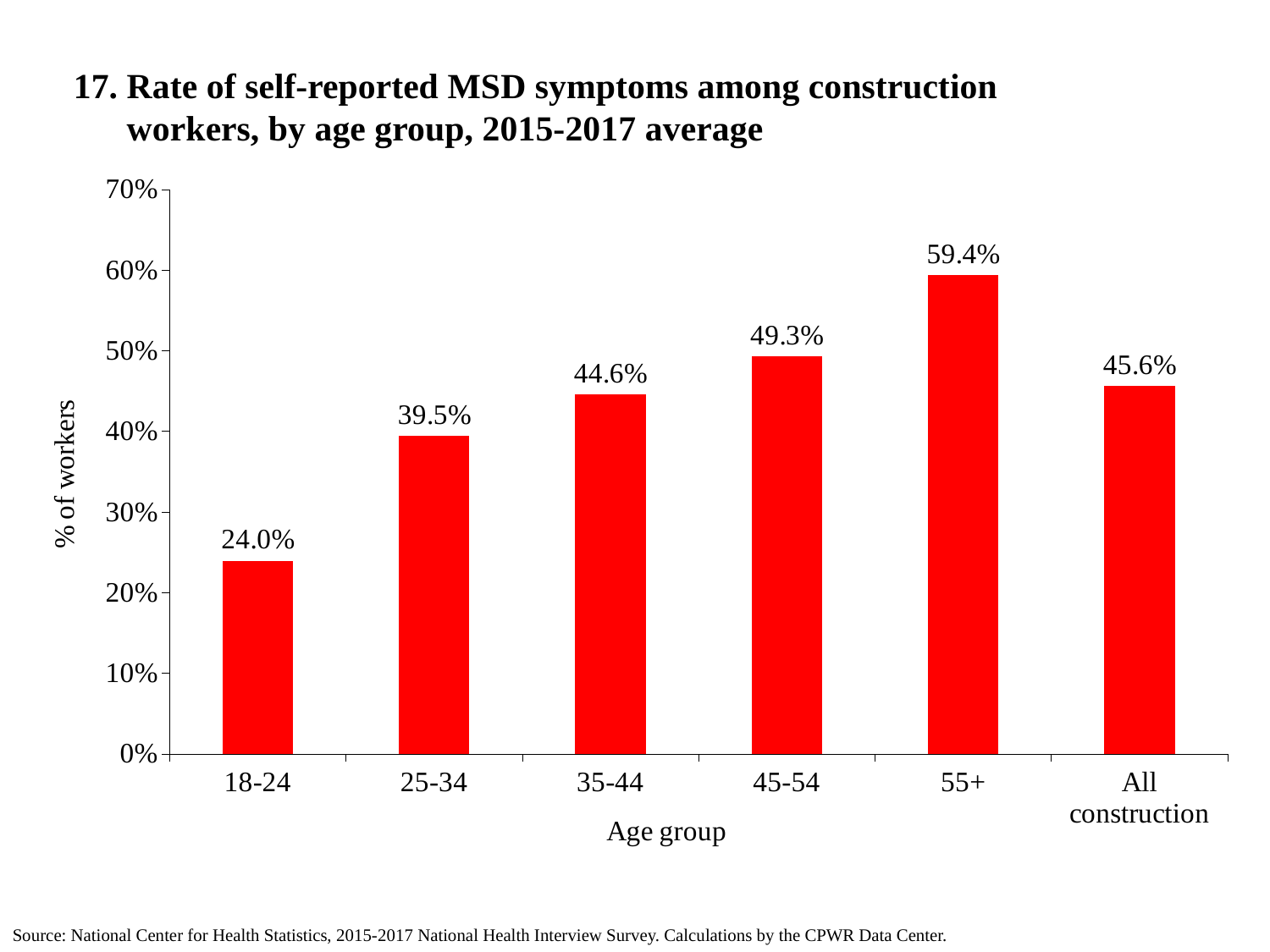
Which is larger, the value for 35-44 or the value for All construction? All construction What is the label of the y axis? % of workers What is the value shown for the 45-54 age group? 49.3% What is the rate of self-reported MSD symptoms for the 18-24 age group? 24.0% What kind of chart is shown on the slide? Bar chart How many bars are shown on the chart? 6 Do the values rise or fall across the age groups from 18-24 to 55+? Rise What is the difference between the 55+ value and the 18-24 value? 35.4 percentage points Which age group has the highest rate of self-reported MSD symptoms? 55+ Which category has the lowest value on the chart? 18-24 What is the value shown for All construction? 45.6% Is the value for 25-34 greater or less than 40%? less